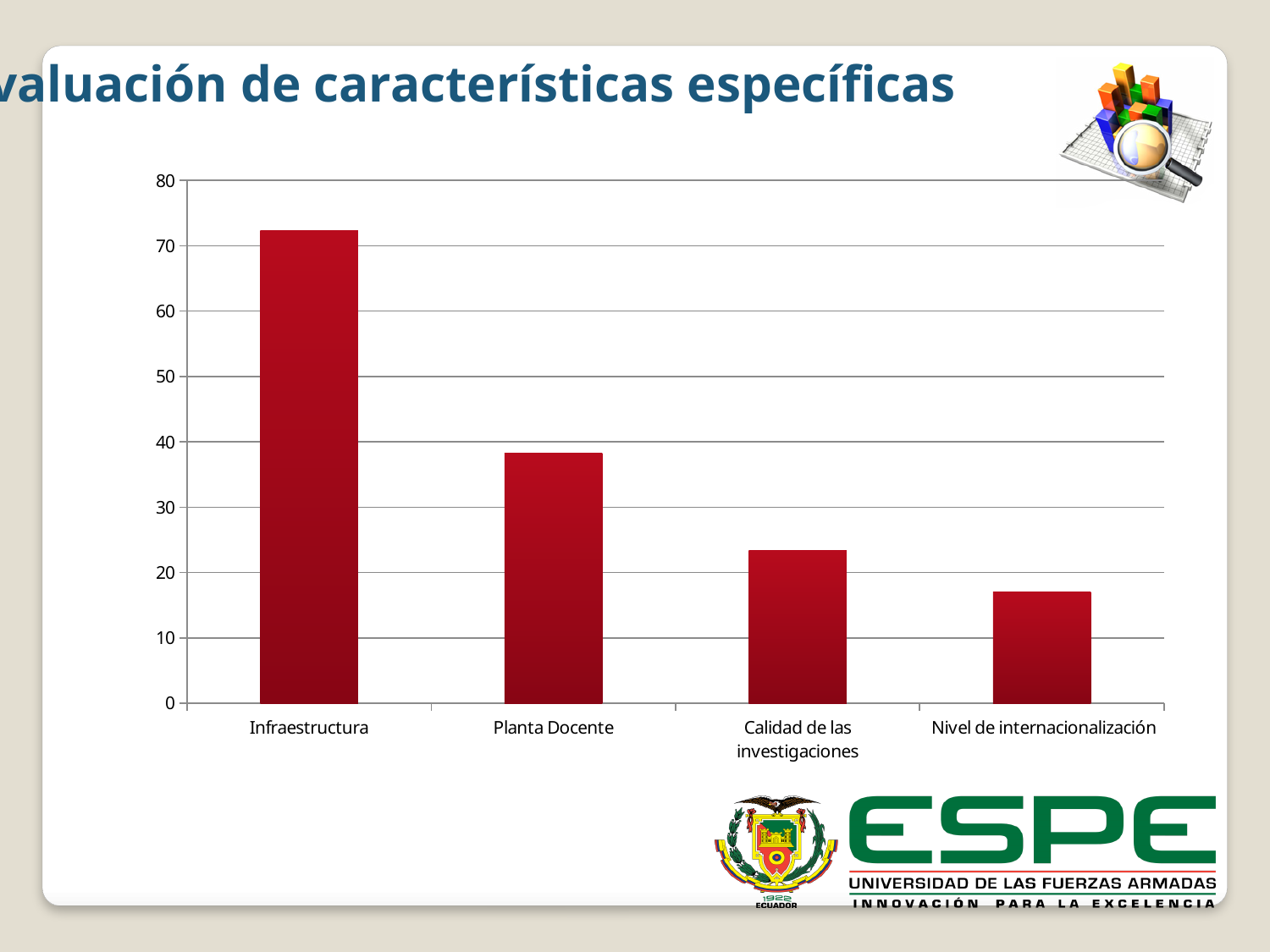
Is the value for Nivel de internacionalización greater or less than 20? less Which category has the highest bar in the chart? Infraestructura What is the maximum value shown on the vertical axis of the chart? 80 Is the value for Calidad de las investigaciones greater or less than 20? greater Is the value for Infraestructura greater or less than 70? greater What kind of chart is shown on the slide? bar chart Do the bar values rise or fall from left to right along the x axis? fall Which category has the lowest bar in the chart? Nivel de internacionalización Which is larger, the value for Planta Docente or the value for Calidad de las investigaciones? Planta Docente How many categories are shown on the x axis of the chart? 4 Which is larger, the value for Infraestructura or the value for Nivel de internacionalización? Infraestructura